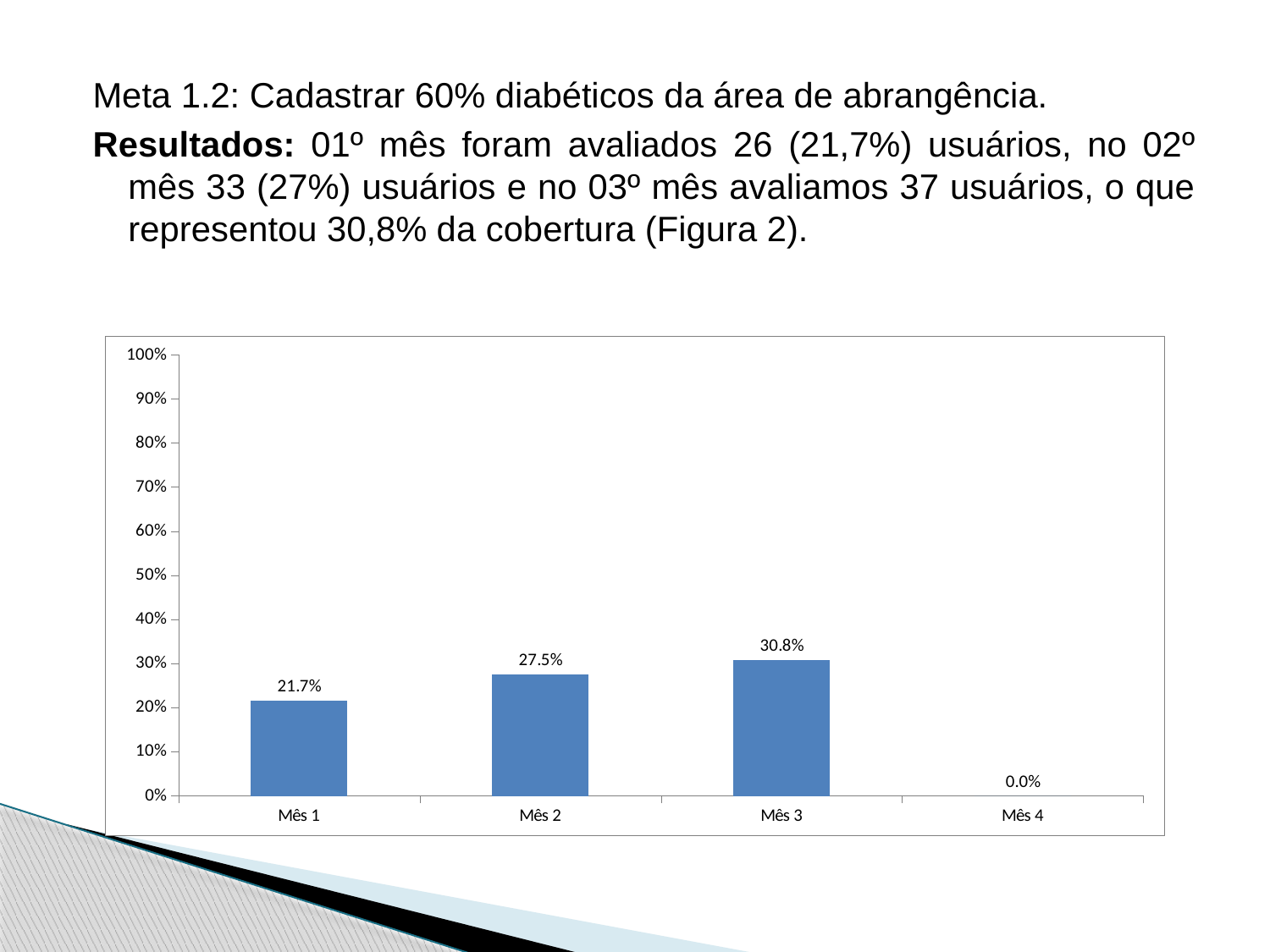
What is the value for Mês 4? 0.0% What is the value for Mês 1? 21.7% Is the value for Mês 3 greater or less than 40%? less How many categories are shown on the x axis? 4 What kind of chart is shown on the slide? bar chart Which is larger, the value for Mês 2 or the value for Mês 1? Mês 2 What is the value for Mês 2? 27.5% Which category has the lowest value? Mês 4 Which category has the highest value? Mês 3 What is the value for Mês 3? 30.8% Do the values rise or fall from Mês 1 to Mês 3? rise What is the difference between the values for Mês 3 and Mês 1? 9.1%